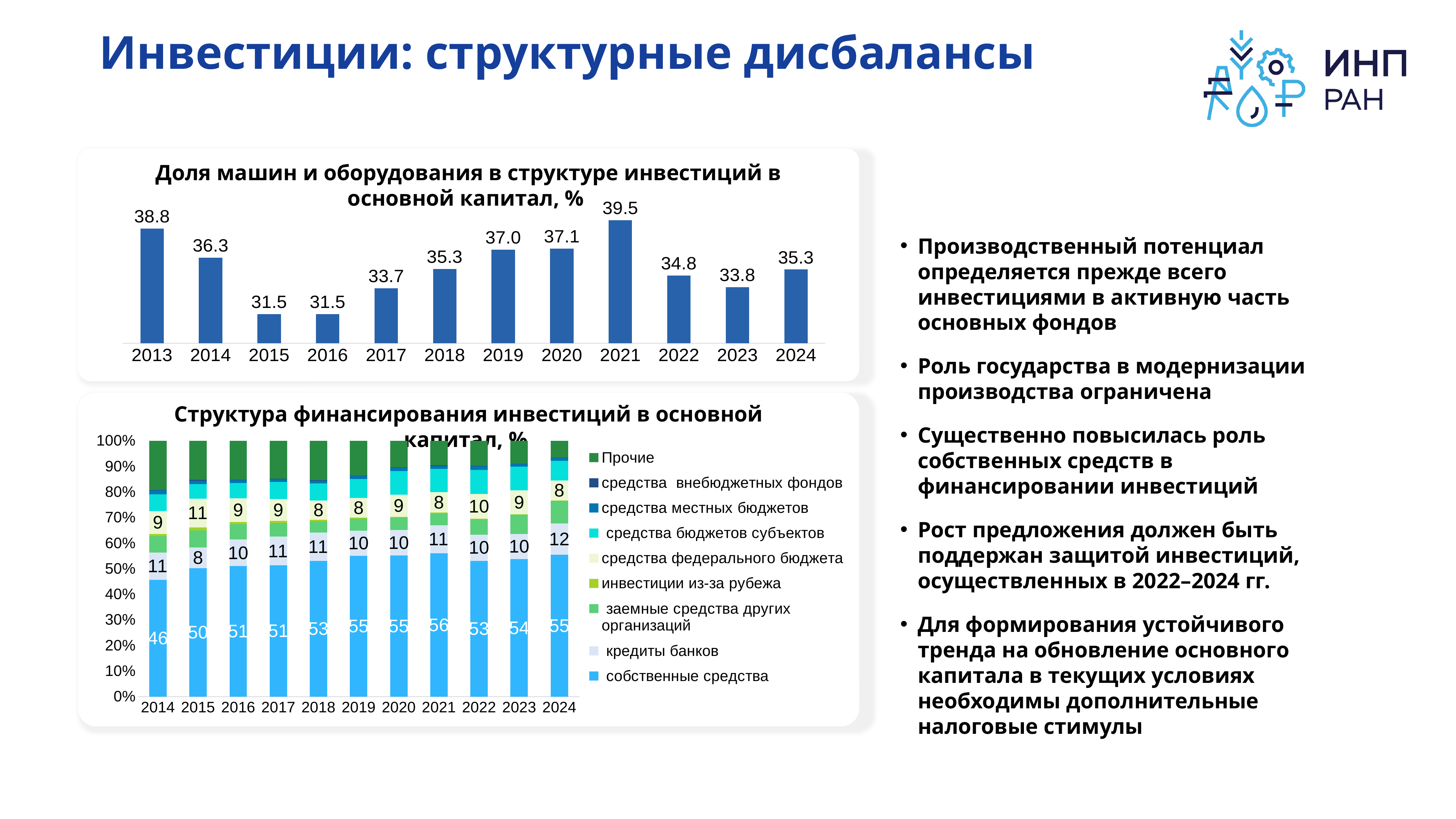
In the top chart 'Доля машин и оборудования в структуре инвестиций в основной капитал, %', what is the value for 2021? 39.5 What kind of chart is the top chart 'Доля машин и оборудования в структуре инвестиций в основной капитал, %'? bar chart In the top chart 'Доля машин и оборудования в структуре инвестиций в основной капитал, %', which year has the highest value? 2021 In the top chart 'Доля машин и оборудования в структуре инвестиций в основной капитал, %', do the values rise or fall from 2013 to 2016? fall In the bottom chart 'Структура финансирования инвестиций в основной капитал, %', how many years are shown on the x axis? 11 In the top chart 'Доля машин и оборудования в структуре инвестиций в основной капитал, %', which year has the larger value, 2014 or 2022? 2014 In the top chart 'Доля машин и оборудования в структуре инвестиций в основной капитал, %', what is the difference between the values for 2013 and 2024? 3.5 In the top chart 'Доля машин и оборудования в структуре инвестиций в основной капитал, %', what is the lowest value shown? 31.5 In the bottom chart 'Структура финансирования инвестиций в основной капитал, %', what is the value for 'собственные средства' in 2024? 55 In the bottom chart 'Структура финансирования инвестиций в основной капитал, %', how many series does the legend list? 9 In the top chart 'Доля машин и оборудования в структуре инвестиций в основной капитал, %', how many years are shown? 12 In the bottom chart 'Структура финансирования инвестиций в основной капитал, %', what is the value for 'кредиты банков' in 2015? 8